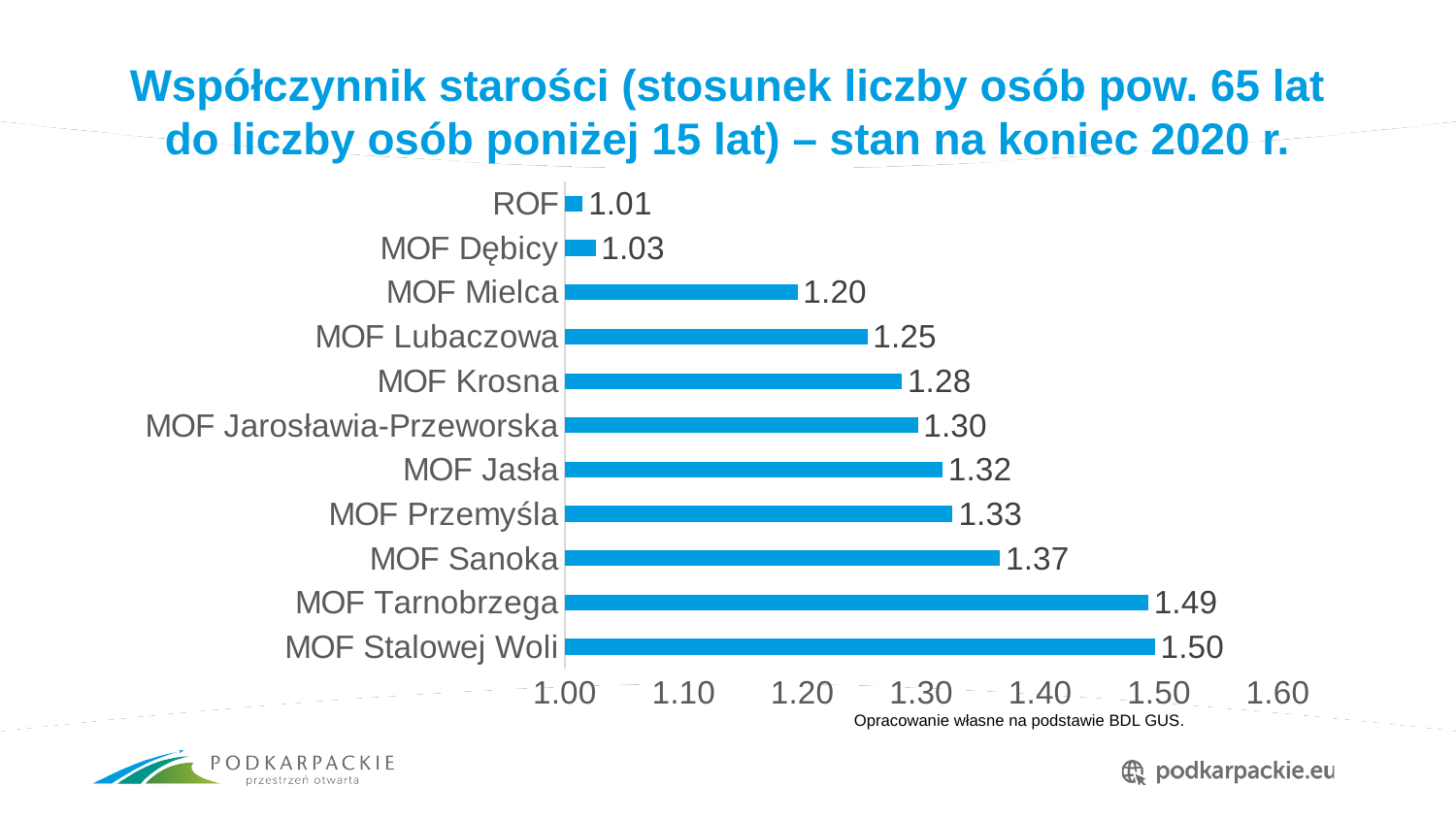
What kind of chart is shown on the slide? bar chart What is the value for MOF Sanoka? 1.37 Which is larger, the value for MOF Krosna or the value for MOF Lubaczowa? MOF Krosna How many categories are shown in the chart? 11 What is the value for MOF Mielca? 1.20 What is the source note printed below the chart? Opracowanie własne na podstawie BDL GUS. What is the difference between the values for MOF Tarnobrzega and MOF Dębicy? 0.46 Is the value for MOF Przemyśla greater or less than 1.40? less Which category has the lowest value? ROF What is the value for MOF Jarosławia-Przeworska? 1.30 What is the value for ROF? 1.01 Which category has the highest value? MOF Stalowej Woli